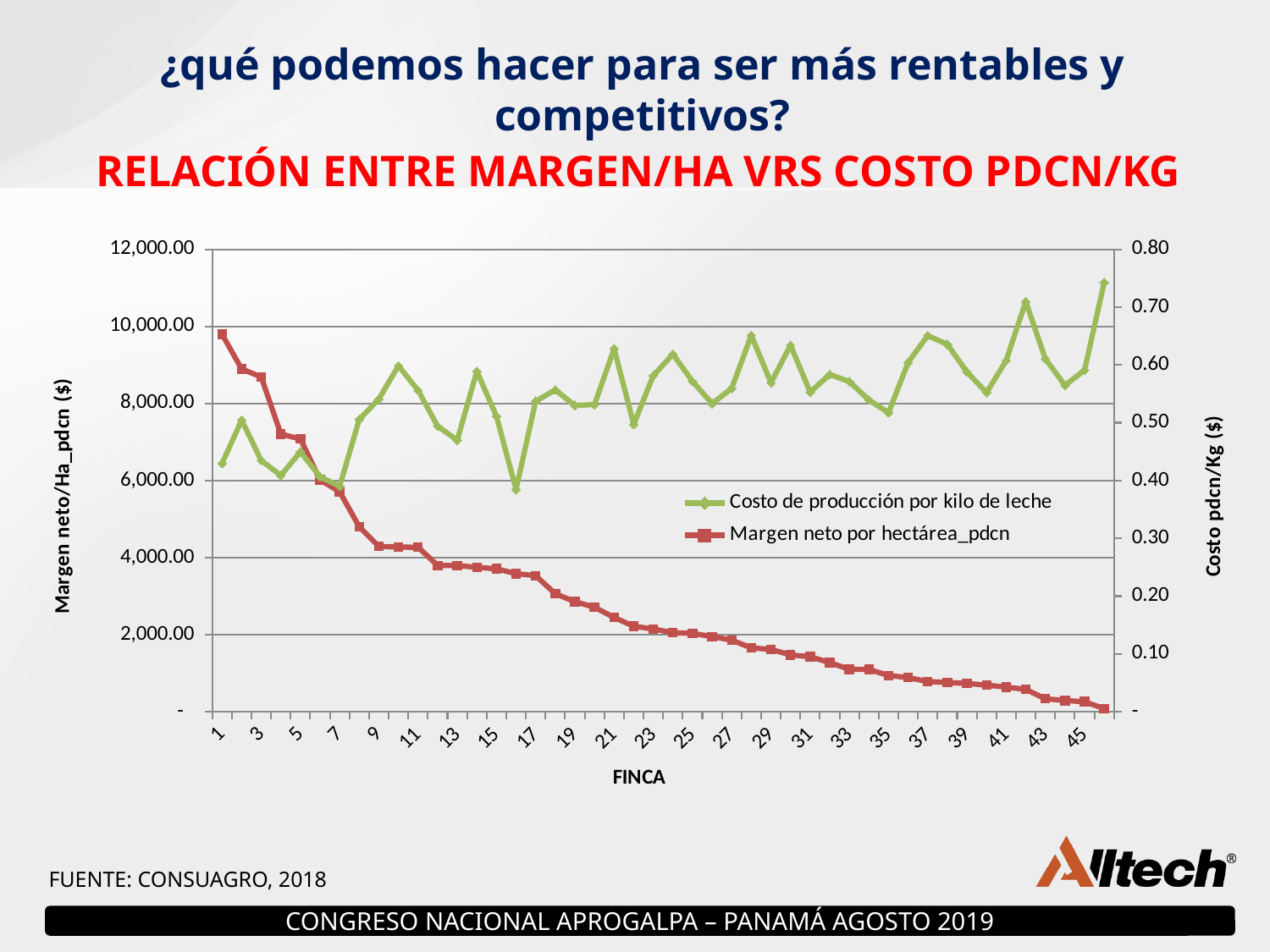
How many series does the chart legend list? 2 Which finca has the highest value for 'Margen neto por hectárea_pdcn'? 1 Does the 'Margen neto por hectárea_pdcn' series rise or fall as the finca number increases along the x axis? fall What is the title of the x axis of the chart? FINCA Which is larger, the 'Margen neto por hectárea_pdcn' value for finca 1 or for finca 45? finca 1 Is the 'Margen neto por hectárea_pdcn' value for finca 35 greater or less than 2,000.00? less What kind of chart is shown on the slide? line chart Is the 'Margen neto por hectárea_pdcn' value for finca 9 greater or less than 6,000.00? less What colour is the line for 'Costo de producción por kilo de leche'? green Does the 'Costo de producción por kilo de leche' series generally rise or fall as the finca number increases along the x axis? rise Is the 'Margen neto por hectárea_pdcn' value for finca 1 greater or less than 8,000.00? greater